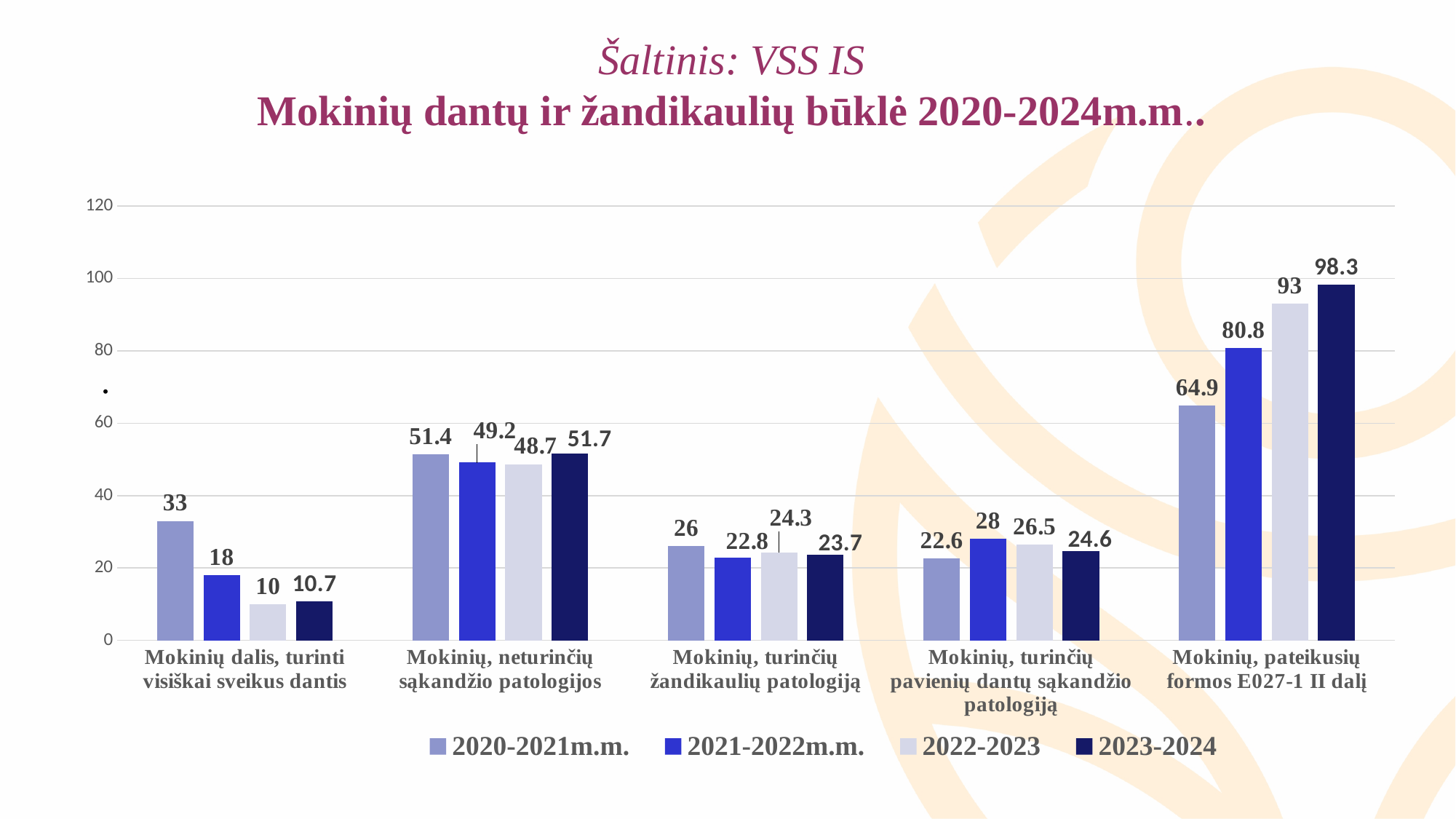
What is the value for 2020-2021m.m. in the category "Mokinių dalis, turinti visiškai sveikus dantis"? 33 What kind of chart is shown on the slide? Bar chart In the category "Mokinių, turinčių žandikaulių patologiją", which is larger: the 2020-2021m.m. value or the 2021-2022m.m. value? 2020-2021m.m. How many series does the legend list? 4 What is the value for 2021-2022m.m. in the category "Mokinių, turinčių pavienių dantų sąkandžio patologiją"? 28 What is the value for 2022-2023 in the category "Mokinių, neturinčių sąkandžio patologijos"? 48.7 Which series has the lowest value in the category "Mokinių dalis, turinti visiškai sveikus dantis"? 2022-2023 What is the value for 2023-2024 in the category "Mokinių, pateikusių formos E027-1 II dalį"? 98.3 Which series has the highest value in the category "Mokinių, pateikusių formos E027-1 II dalį"? 2023-2024 What is the difference between the 2023-2024 and 2020-2021m.m. values in the category "Mokinių, pateikusių formos E027-1 II dalį"? 33.4 Do the values for "Mokinių, pateikusių formos E027-1 II dalį" rise or fall from 2020-2021m.m. to 2023-2024? Rise How many categories are shown on the x axis? 5